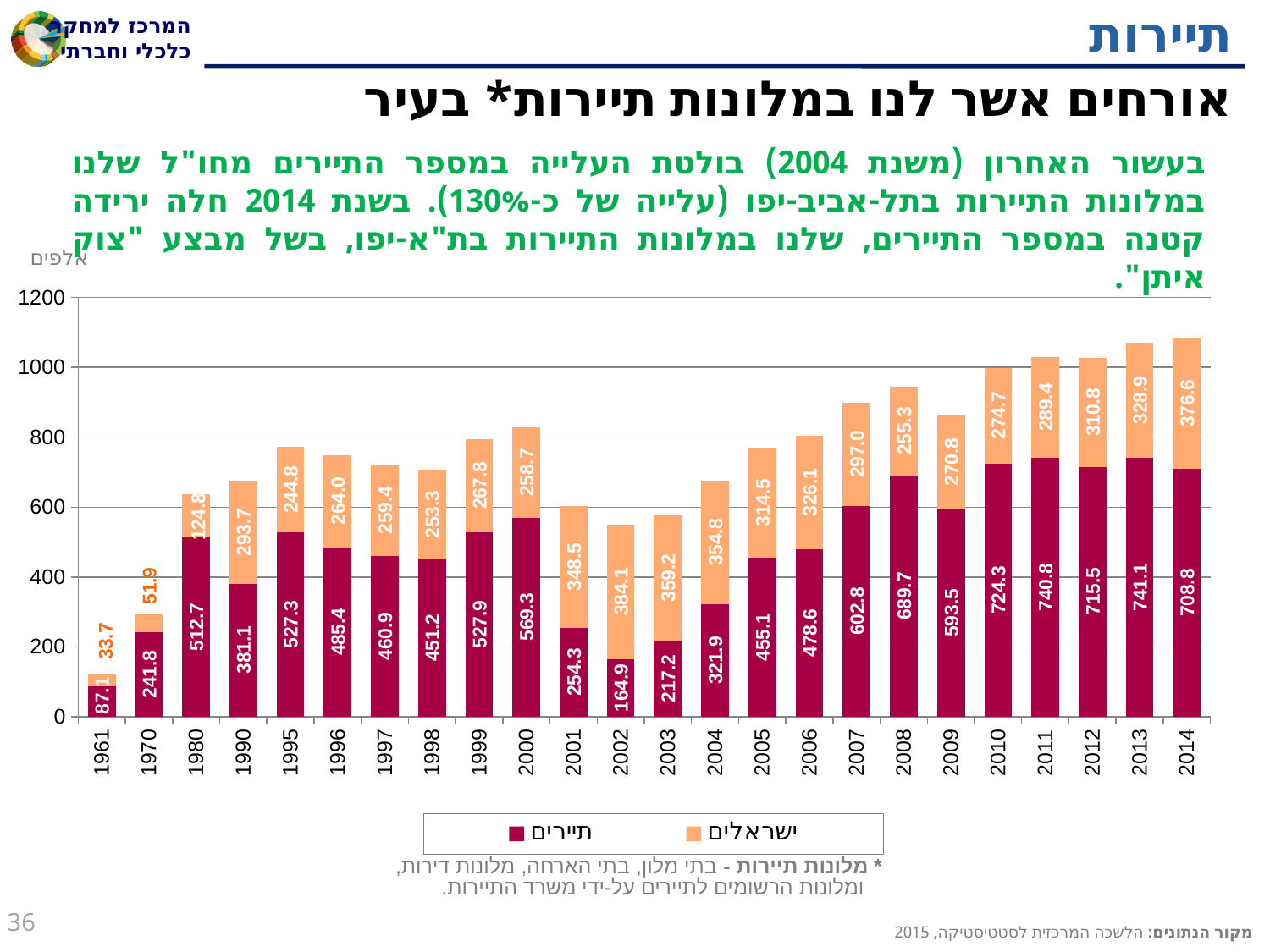
What is the difference between תיירים and ישראלים in 2014? 332.2 How many years are shown on the x axis? 24 What is the value for תיירים (tourists) in 2014? 708.8 What is the total of the stacked bar for 2002? 549.0 Is the total height of the 2014 stacked bar greater or less than 1000? greater How many series does the legend list? 2 What is the value for ישראלים (Israelis) in 2002? 384.1 What kind of chart is shown? stacked bar chart What is the value for תיירים in 1961? 87.1 In 2002, which is larger: תיירים or ישראלים? ישראלים In which year is the תיירים series lowest? 1961 In which year is the ישראלים series highest? 2002